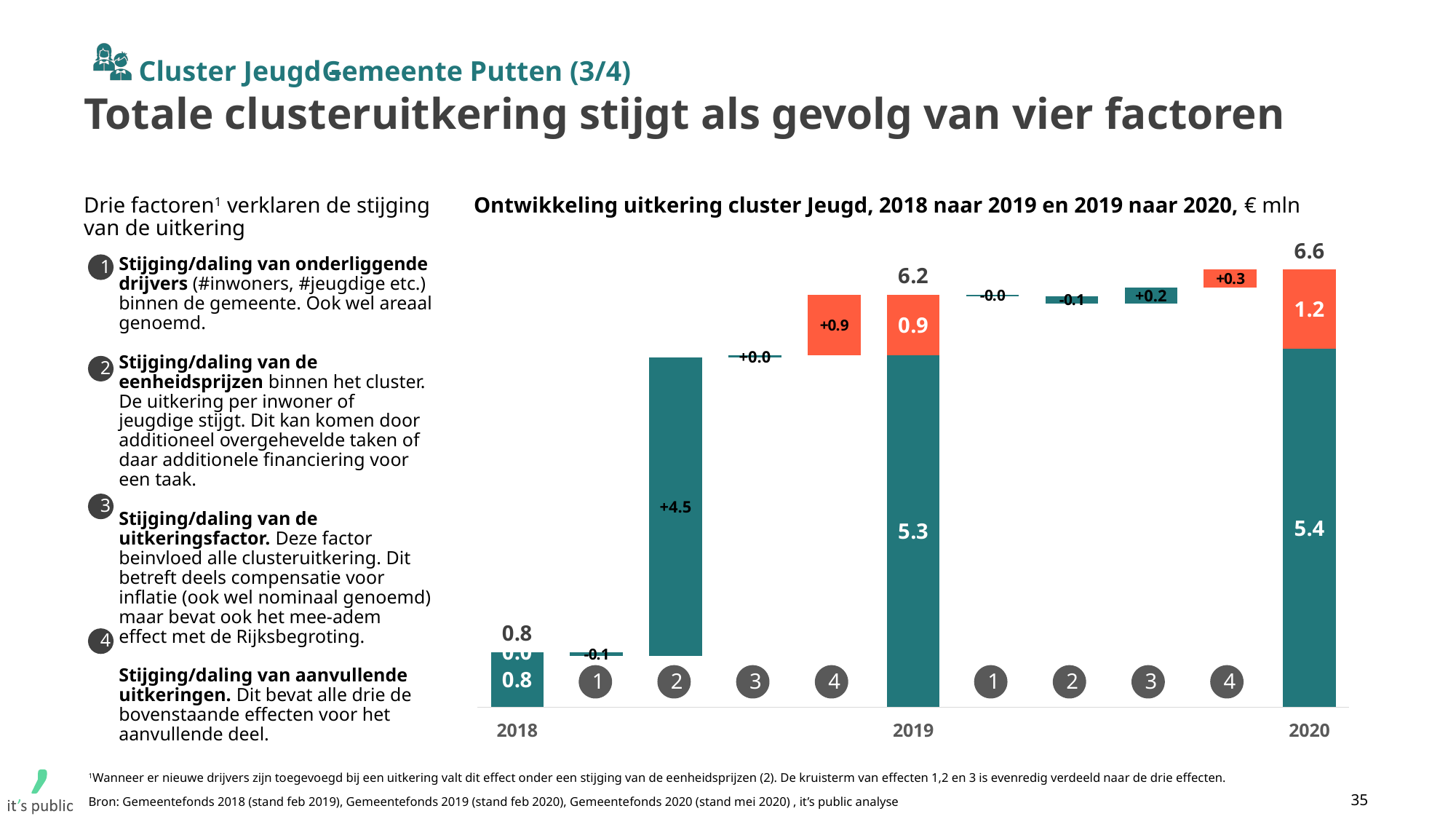
What is the total uitkering for cluster Jeugd in 2019 according to the chart? 6.2 Between 2018 and 2019, which factor has the larger effect: factor 2 or factor 4? Factor 2 What is the total uitkering for cluster Jeugd in 2020 according to the chart? 6.6 Which year has the highest total uitkering in the chart? 2020 Do the total uitkering values rise or fall from 2018 to 2020? Rise What is the total uitkering for cluster Jeugd in 2018 according to the chart? 0.8 What is the effect of factor 2 (eenheidsprijzen) on the uitkering from 2018 to 2019? +4.5 What is the value of the teal (lower) segment of the 2020 bar? 5.4 What is the effect of factor 4 (aanvullende uitkeringen) on the uitkering from 2018 to 2019? +0.9 What kind of chart is shown on the slide? Waterfall bar chart What is the difference between the total uitkering in 2020 and in 2019? 0.4 What is the value of the orange (upper) segment of the 2019 bar? 0.9